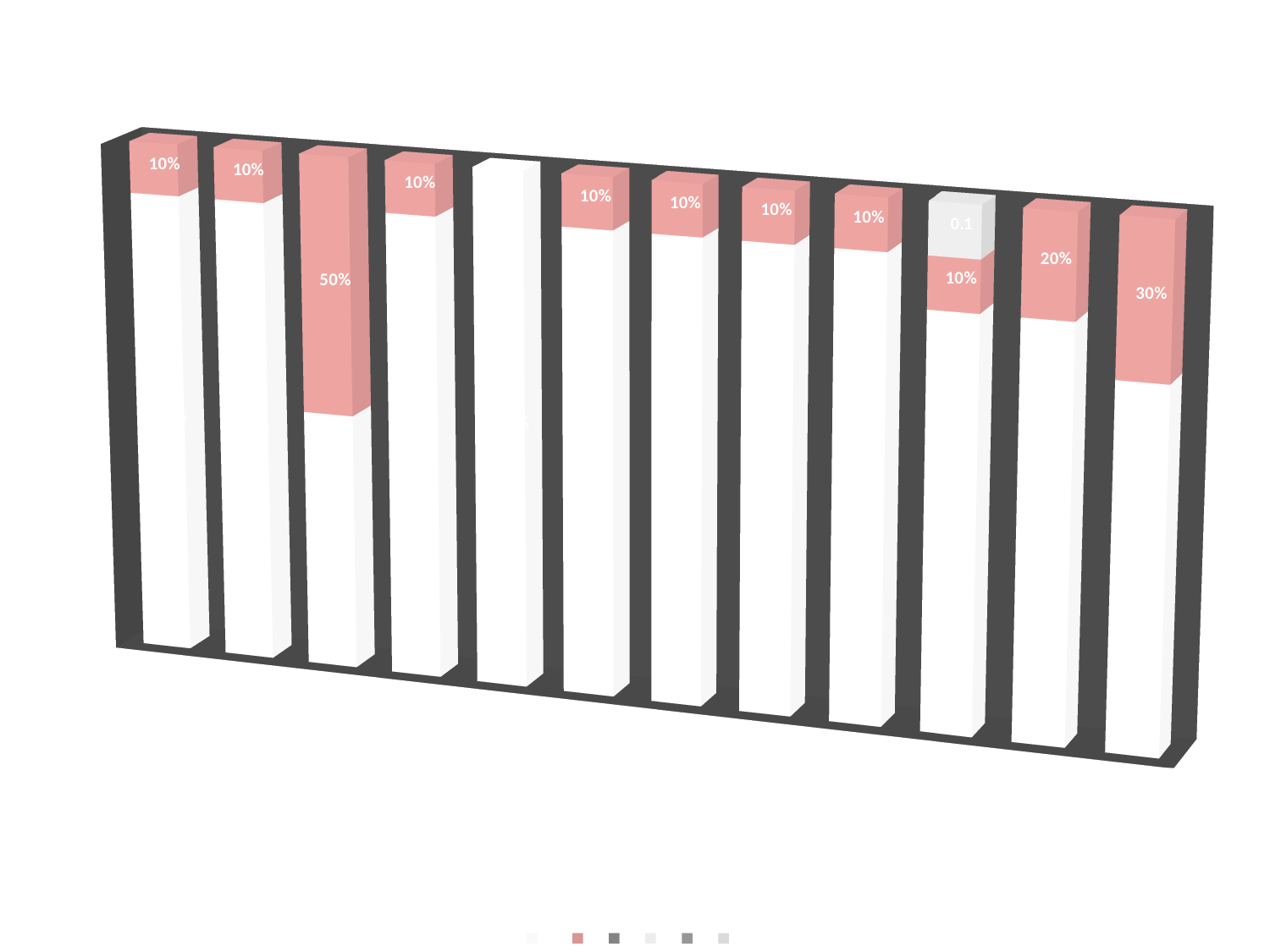
What is the pink segment value labelled on the first bar from the left? 10% What is the pink segment value labelled on the third bar from the left? 50% How many legend entries are shown below the chart? 6 What is the difference between the pink segment of the third bar from the left (50%) and the pink segment of the rightmost bar (30%)? 20% Which bar has the largest pink segment? the third bar from the left What kind of chart is shown on the slide? bar chart Which bar from the left has no pink segment label? the fifth bar What is the pink segment value labelled on the second bar from the right? 20% Which is larger: the pink segment of the third bar from the left or the pink segment of the rightmost bar? the third bar from the left What is the pink segment value labelled on the rightmost bar? 30% What value is labelled on the grey segment of the tenth bar from the left? 0.1 How many bars are plotted in the chart? 12